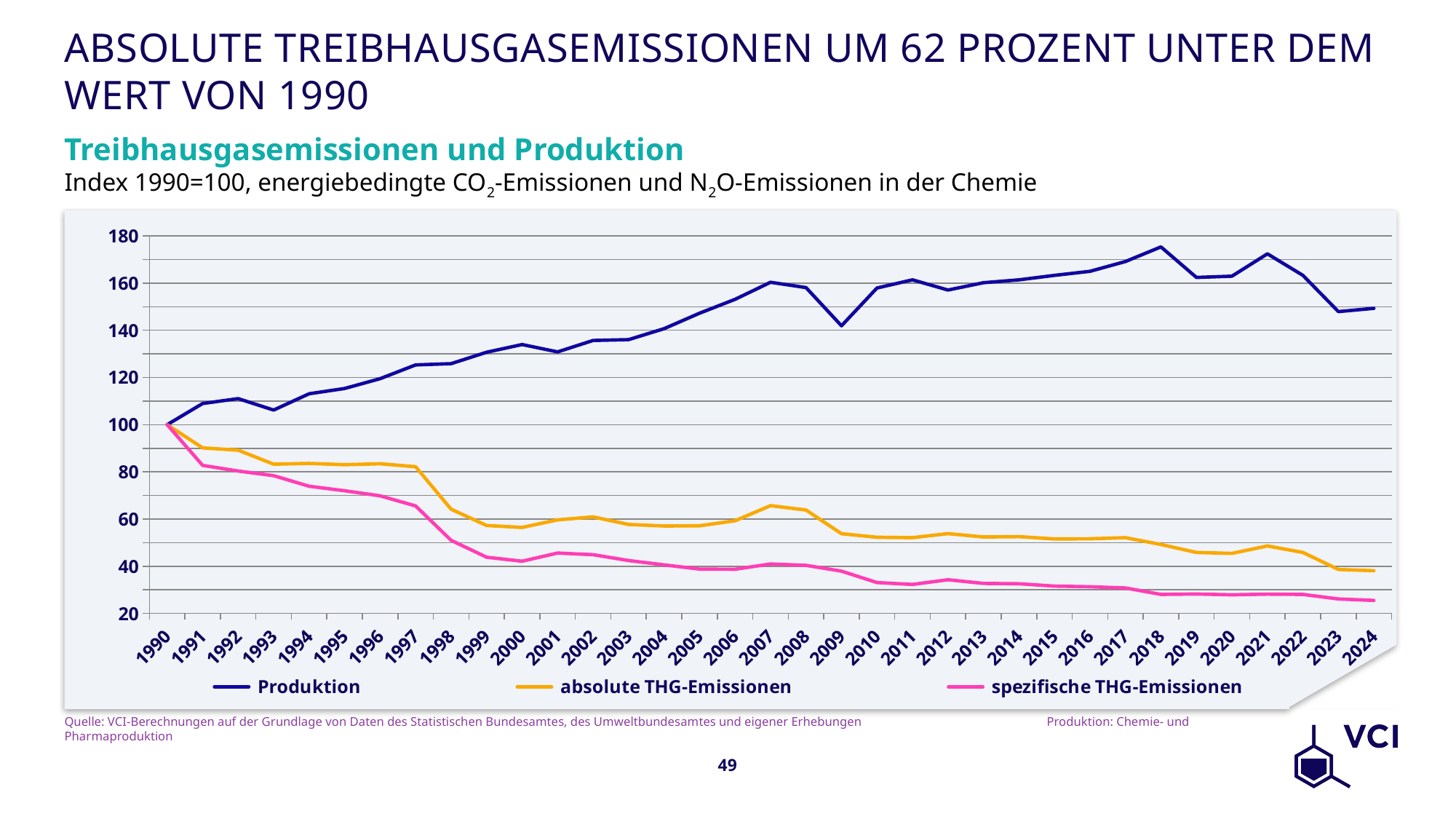
In which year does Produktion reach its highest value? 2018 How many years are plotted along the x axis? 35 What kind of chart is shown on the slide? line chart Is the value for spezifische THG-Emissionen in 2024 greater or less than 40? less Is the value for Produktion in 2018 greater or less than 160? greater Is the value for absolute THG-Emissionen in 2007 greater or less than 60? greater What is the value of Produktion in 1990? 100 In 2024, which is larger: Produktion or absolute THG-Emissionen? Produktion What is the title of the chart? Treibhausgasemissionen und Produktion How many series does the legend list? 3 Does the absolute THG-Emissionen line generally rise or fall from 1990 to 2024? fall